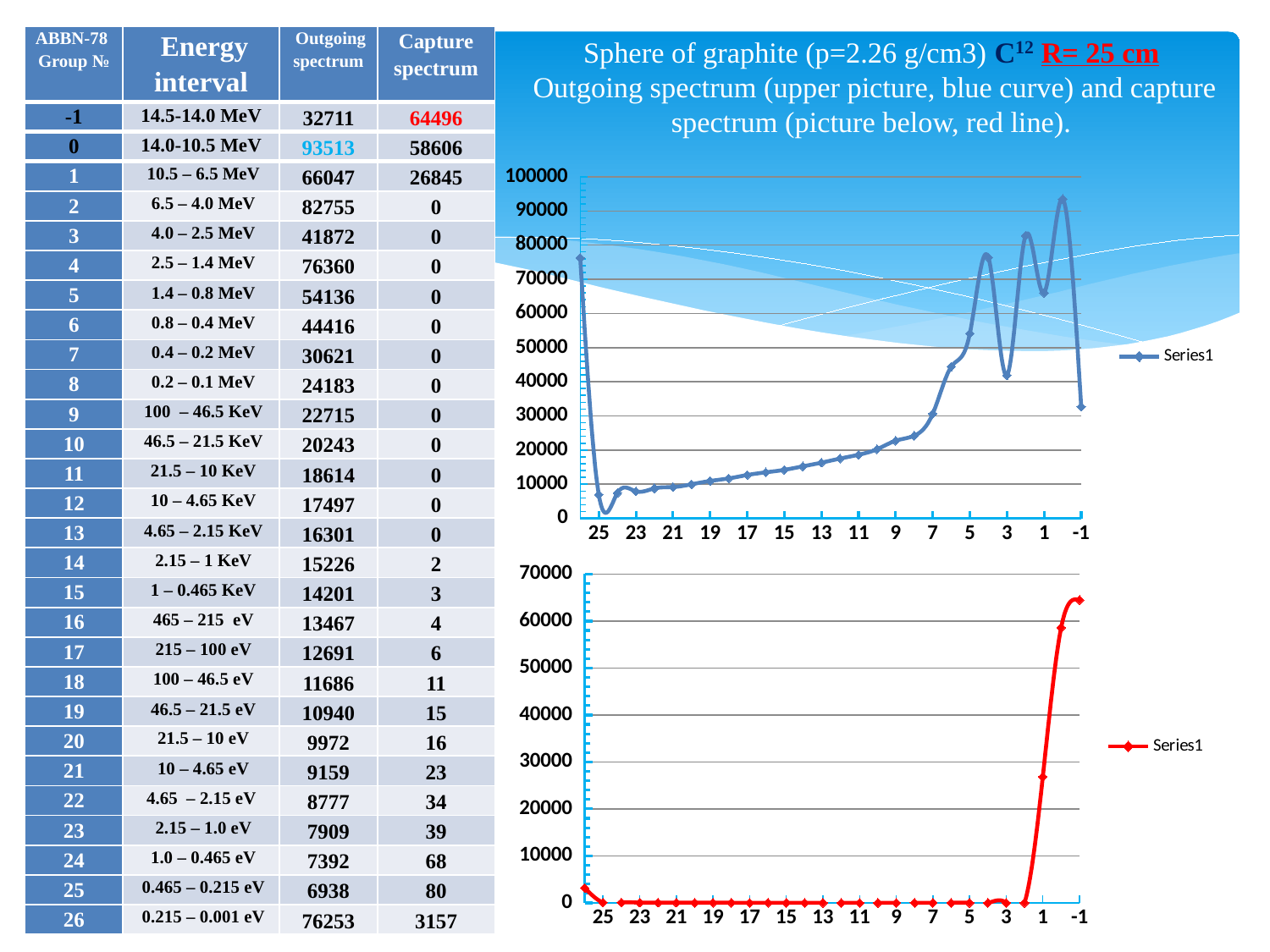
In the lower chart, is the value at the last point (x = -1) greater or less than 60000? greater In the lower chart, do the values rise or fall between x = 3 and x = -1? rise What is the highest tick value shown on the y axis of the lower chart? 70000 In the upper chart, is the highest peak of the curve greater or less than 90000? greater What is the legend entry shown for the lower chart? Series1 What kind of chart is the upper chart on the slide? line chart In the lower chart, is the value at x = 13 greater or less than 10000? less What kind of chart is the lower chart on the slide? line chart What colour is the line in the lower chart? red How many series does the legend of the upper chart list? 1